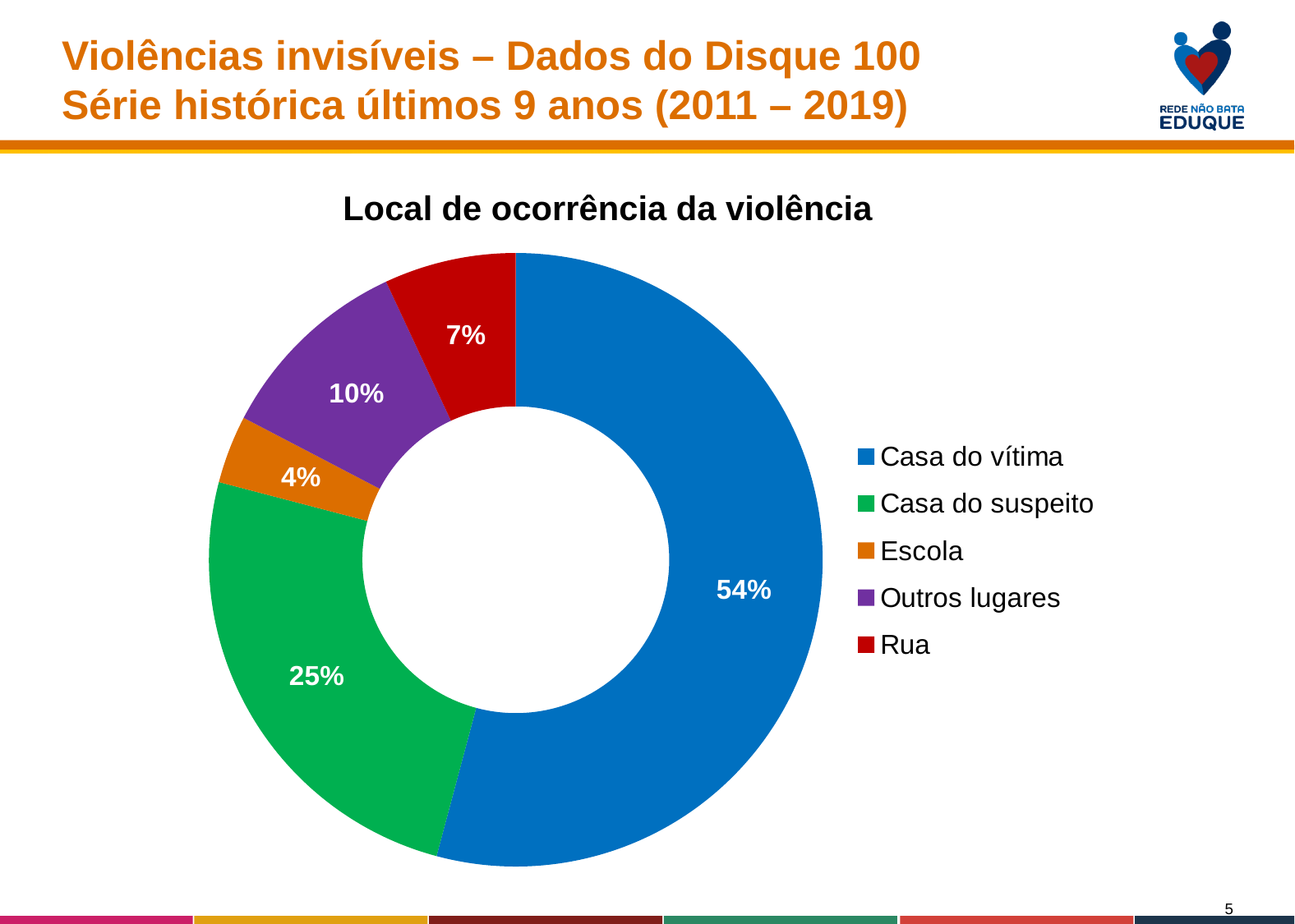
How many categories are shown in the chart? 5 Which category has the smallest share? Escola What kind of chart is shown on the slide? Pie chart (doughnut) What is the value shown for Outros lugares? 10% What is the difference between the shares of Casa do vítima and Casa do suspeito? 29% What is the value shown for Casa do suspeito? 25% Which category has the largest share? Casa do vítima What share of the chart does Casa do vítima represent? 54% What is the title of the chart? Local de ocorrência da violência What is the value shown for Rua? 7% Which is larger, the share for Outros lugares or the share for Rua? Outros lugares What is the value shown for Escola? 4%